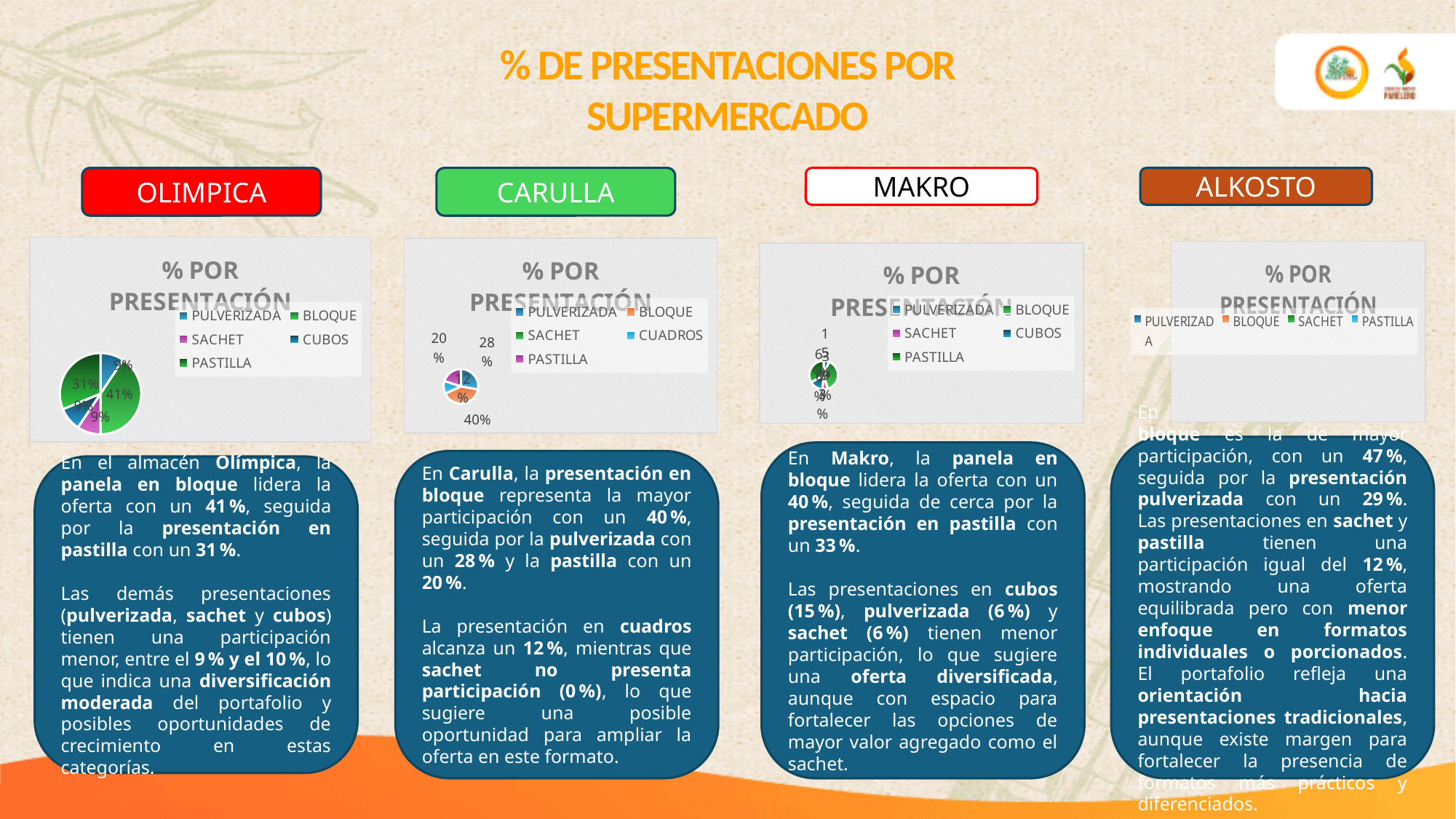
In the OLIMPICA chart, what is the share for PASTILLA? 31% How many entries does the legend of the OLIMPICA chart list? 5 In the CARULLA chart, what is the share for CUADROS? 12% In the OLIMPICA chart, what is the value of the largest slice? 41% In the OLIMPICA chart, which presentation has the largest share? BLOQUE How many entries does the legend of the ALKOSTO chart list? 4 In the CARULLA chart, what is the share for BLOQUE? 40% In the OLIMPICA chart, what is the difference between the BLOQUE share and the PASTILLA share? 10 percentage points Which legend entry appears in the CARULLA chart but not in the OLIMPICA chart? CUADROS In the CARULLA chart, which is larger, the BLOQUE share or the PULVERIZADA share? BLOQUE In the CARULLA chart, what is the share for PULVERIZADA? 28% What kind of chart is shown under the OLIMPICA heading? Pie chart